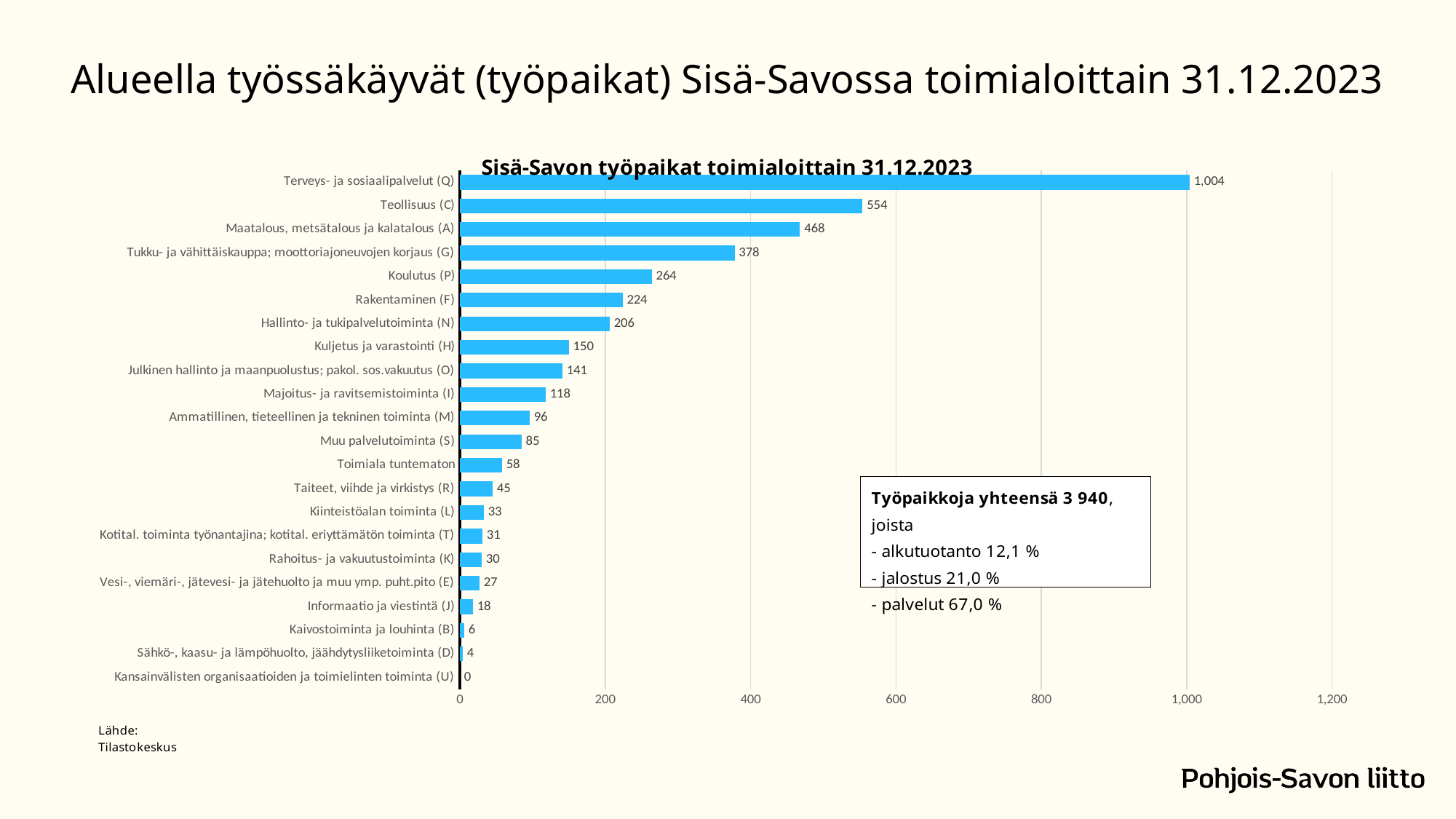
How many categories are shown in the chart? 22 Which is larger, the value for Rakentaminen (F) or the value for Hallinto- ja tukipalvelutoiminta (N)? Rakentaminen (F) What is the difference between the values for Teollisuus (C) and Maatalous, metsätalous ja kalatalous (A)? 86 What is the value for Koulutus (P)? 264 Which category has the highest value? Terveys- ja sosiaalipalvelut (Q) Is the value for Tukku- ja vähittäiskauppa; moottoriajoneuvojen korjaus (G) greater or less than 400? less Which category has the lowest value? Kansainvälisten organisaatioiden ja toimielinten toiminta (U) What kind of chart is shown on the slide? bar chart What is the value for Teollisuus (C)? 554 What is the title of the chart? Sisä-Savon työpaikat toimialoittain 31.12.2023 What is the value for Kaivostoiminta ja louhinta (B)? 6 What is the value for Majoitus- ja ravitsemistoiminta (I)? 118